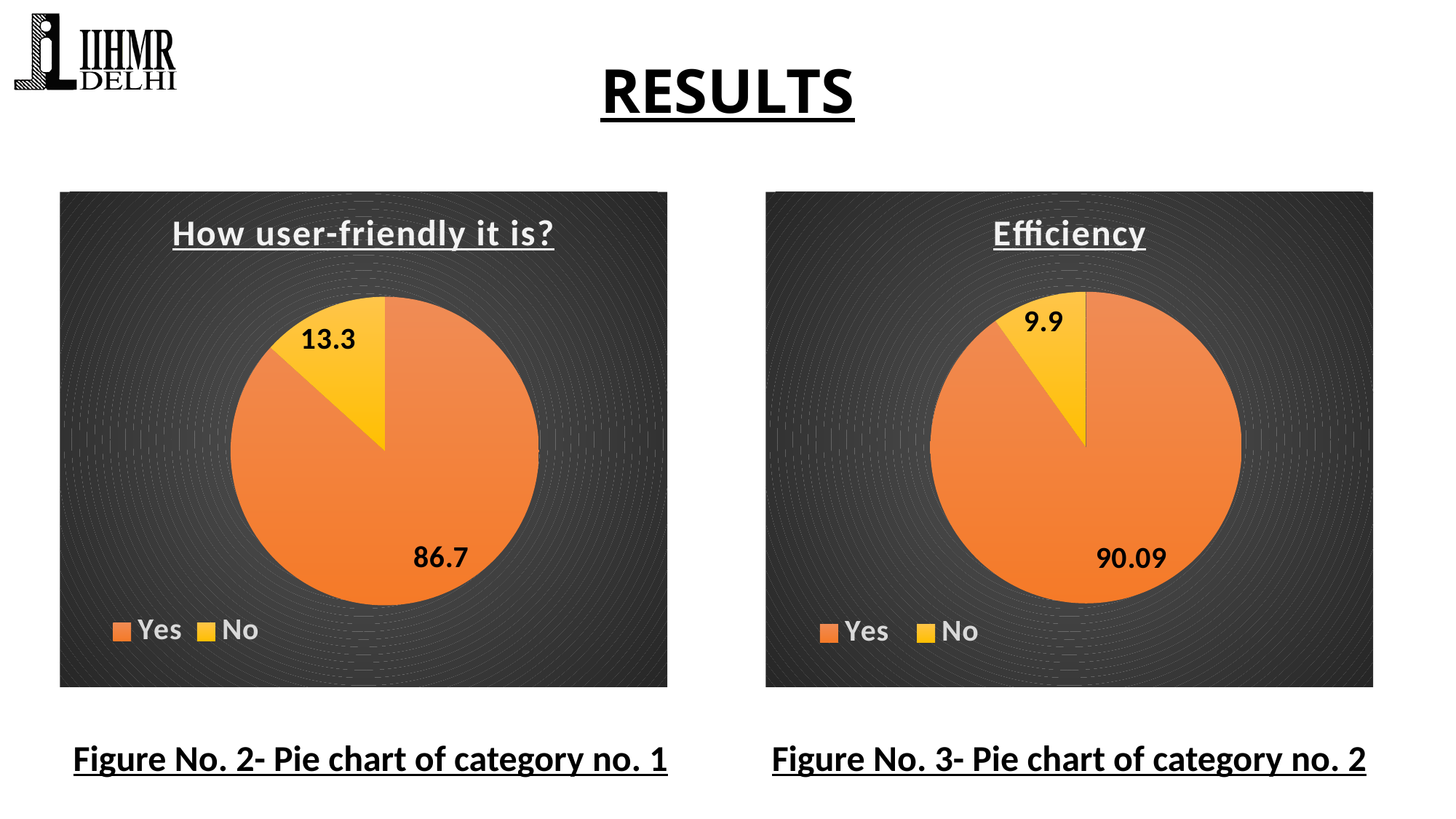
In the "Efficiency" chart, what is the value for Yes? 90.09 In the "How user-friendly it is?" chart, what is the value for No? 13.3 In the "How user-friendly it is?" chart, what is the difference between the Yes and No values? 73.4 What kind of chart is the "Efficiency" chart? pie chart In the "How user-friendly it is?" chart, which colour represents No? yellow In the "Efficiency" chart, which category has the smallest slice? No In the "Efficiency" chart, is the Yes slice larger or smaller than the No slice? larger How many entries does the legend of the "Efficiency" chart list? 2 In the "How user-friendly it is?" chart, what is the value for Yes? 86.7 In the "Efficiency" chart, what is the value for No? 9.9 How many categories does the "How user-friendly it is?" chart show? 2 In the "How user-friendly it is?" chart, which category has the largest slice? Yes